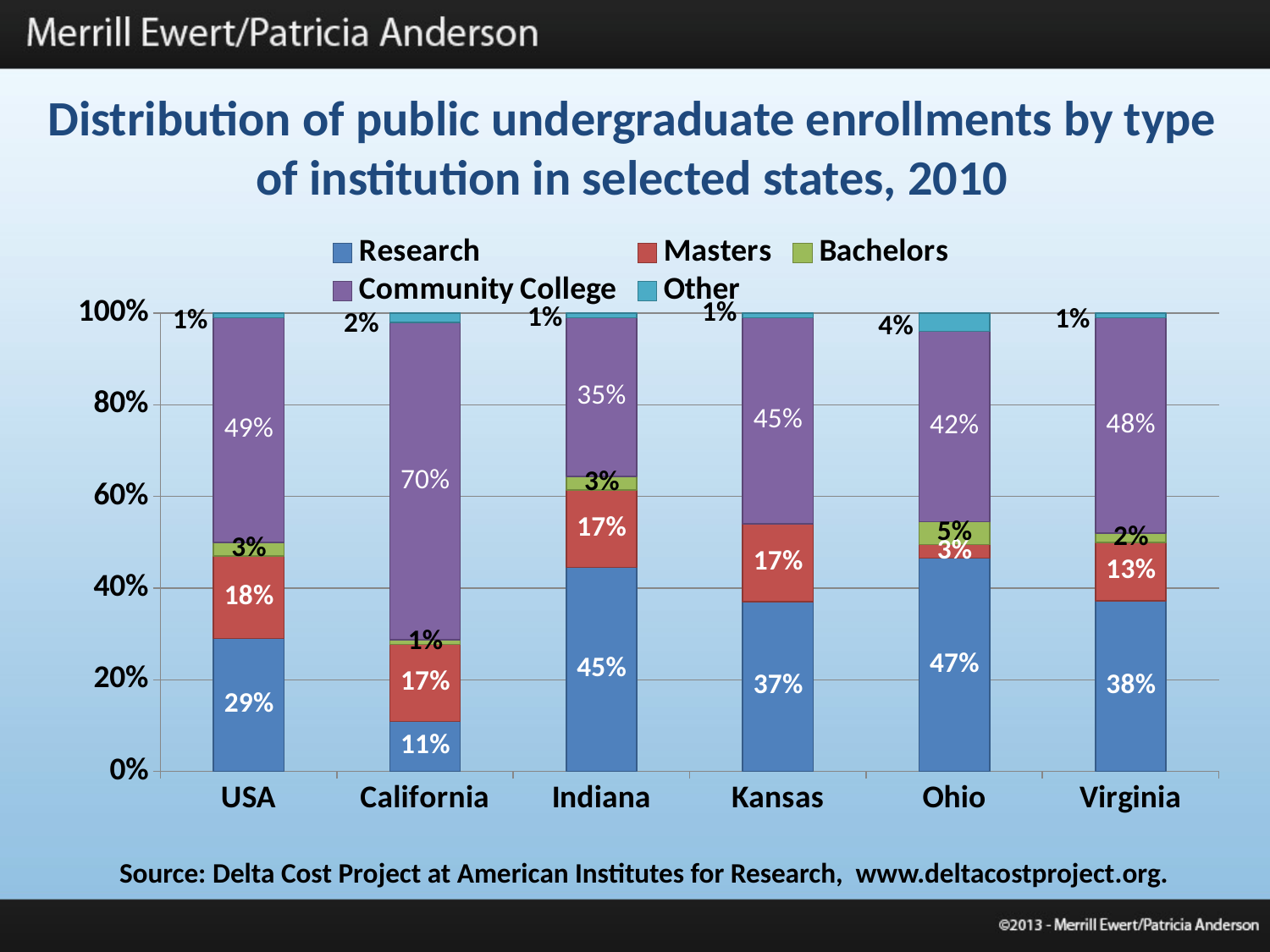
What kind of chart is shown on the slide? Stacked bar chart What is the Research share for Indiana? 45% Which state has the lowest Community College share? Indiana Which state has the highest Research share? Ohio Which is larger, the Research share for Kansas or for Virginia? Virginia How many states or regions are shown on the x axis? 6 Which state has the lowest Research share? California How many series does the legend list? 5 What is the Other share for Ohio? 4% What is the Masters share for Virginia? 13% What is the Community College share for California? 70% What is the difference between the Community College share for California and for Indiana? 35 percentage points